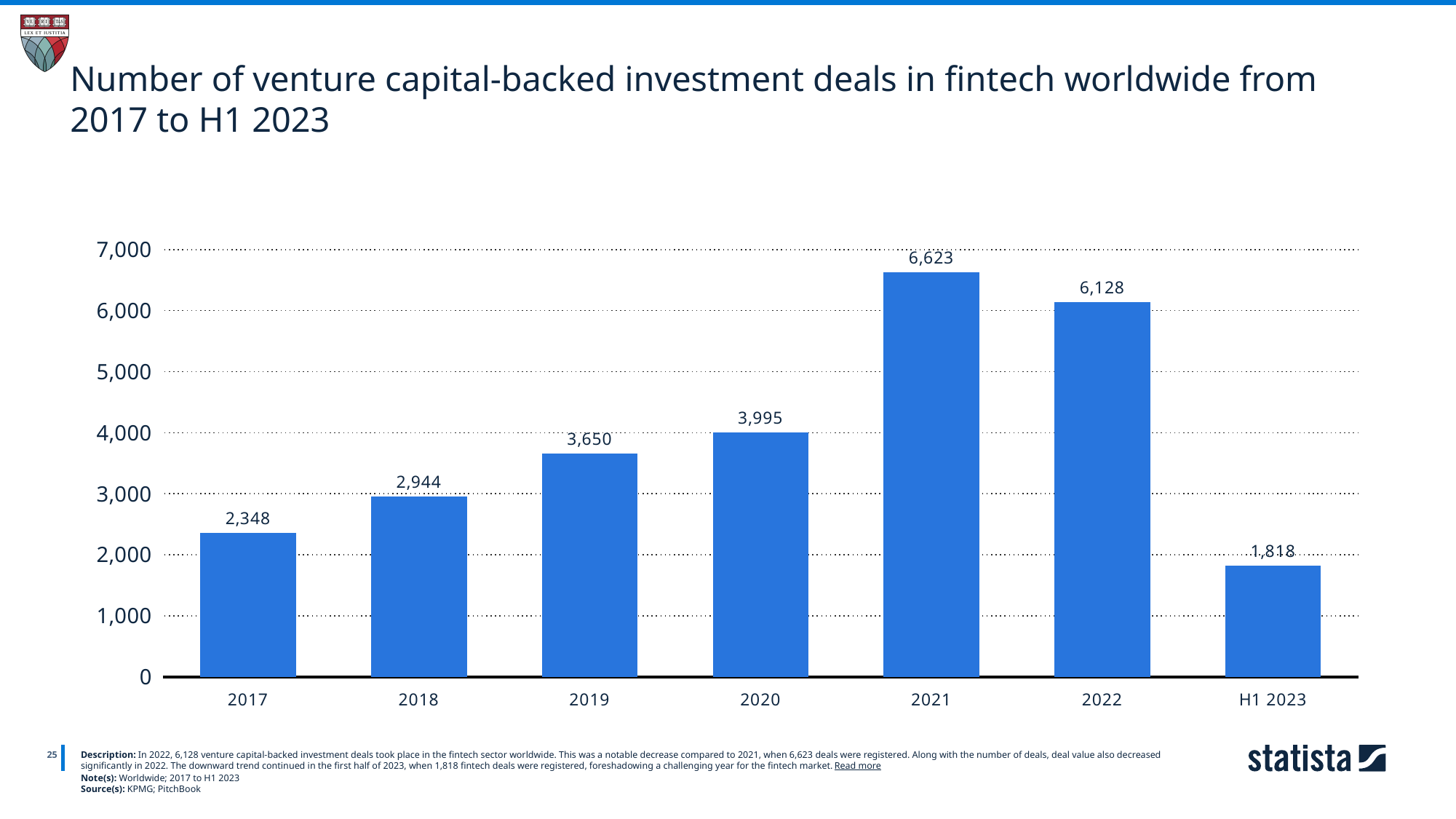
Which year has the highest number of deals? 2021 Which period has the lowest number of deals? H1 2023 Which is larger, the value for 2019 or the value for 2020? 2020 Do the values rise or fall from 2017 to 2021? Rise What is the value shown for H1 2023? 1,818 Is the value for 2022 greater or less than 6,000? greater How many periods are shown on the x axis? 7 What is the difference between the number of deals in 2018 and 2017? 596 How many venture capital-backed fintech deals were there in 2019? 3,650 What is the difference between the number of deals in 2021 and 2022? 495 What kind of chart is shown on the slide? Bar chart What is the value shown for 2020? 3,995